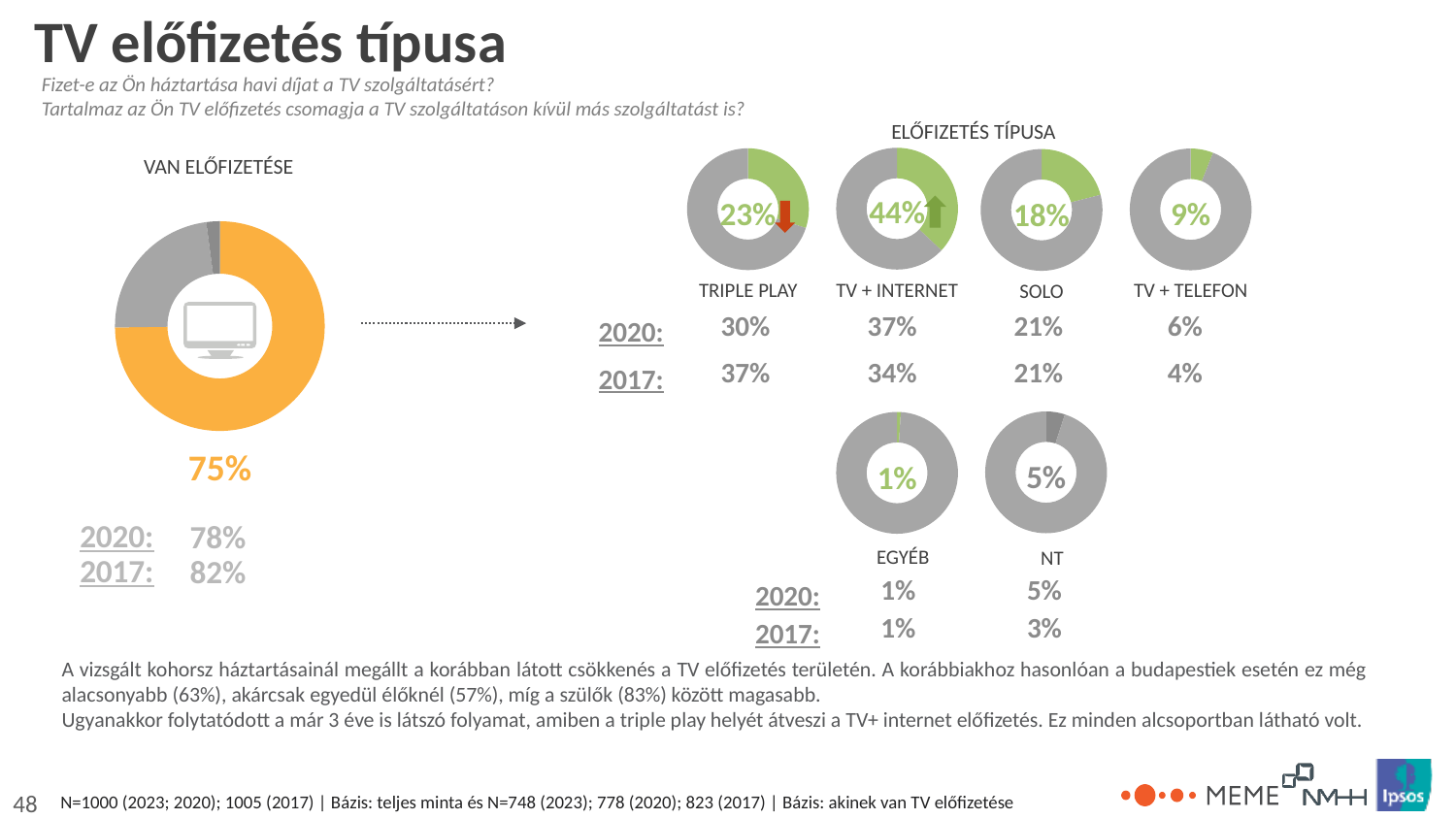
In the 'ELŐFIZETÉS TÍPUSA' charts, what is the value for SOLO? 18% Among the 'ELŐFIZETÉS TÍPUSA' charts, which subscription type has the highest value? TV + INTERNET In the 'ELŐFIZETÉS TÍPUSA' charts, what is the value for TRIPLE PLAY? 23% Among the 'ELŐFIZETÉS TÍPUSA' charts, which subscription type has the lowest value? EGYÉB In the 'ELŐFIZETÉS TÍPUSA' charts, what is the difference between TV + INTERNET and TRIPLE PLAY? 21 percentage points In the 'ELŐFIZETÉS TÍPUSA' charts, what is the value for NT? 5% How many small donut charts are shown under 'ELŐFIZETÉS TÍPUSA'? 6 In the 'VAN ELŐFIZETÉSE' donut chart, what share is highlighted in orange? 75% In the 'ELŐFIZETÉS TÍPUSA' charts, what is the value for TV + TELEFON? 9% What kind of chart is used for 'VAN ELŐFIZETÉSE'? Donut (pie) chart In the 'ELŐFIZETÉS TÍPUSA' charts, what is the value for TV + INTERNET? 44% In the 'ELŐFIZETÉS TÍPUSA' charts, which is larger: SOLO or TV + TELEFON? SOLO